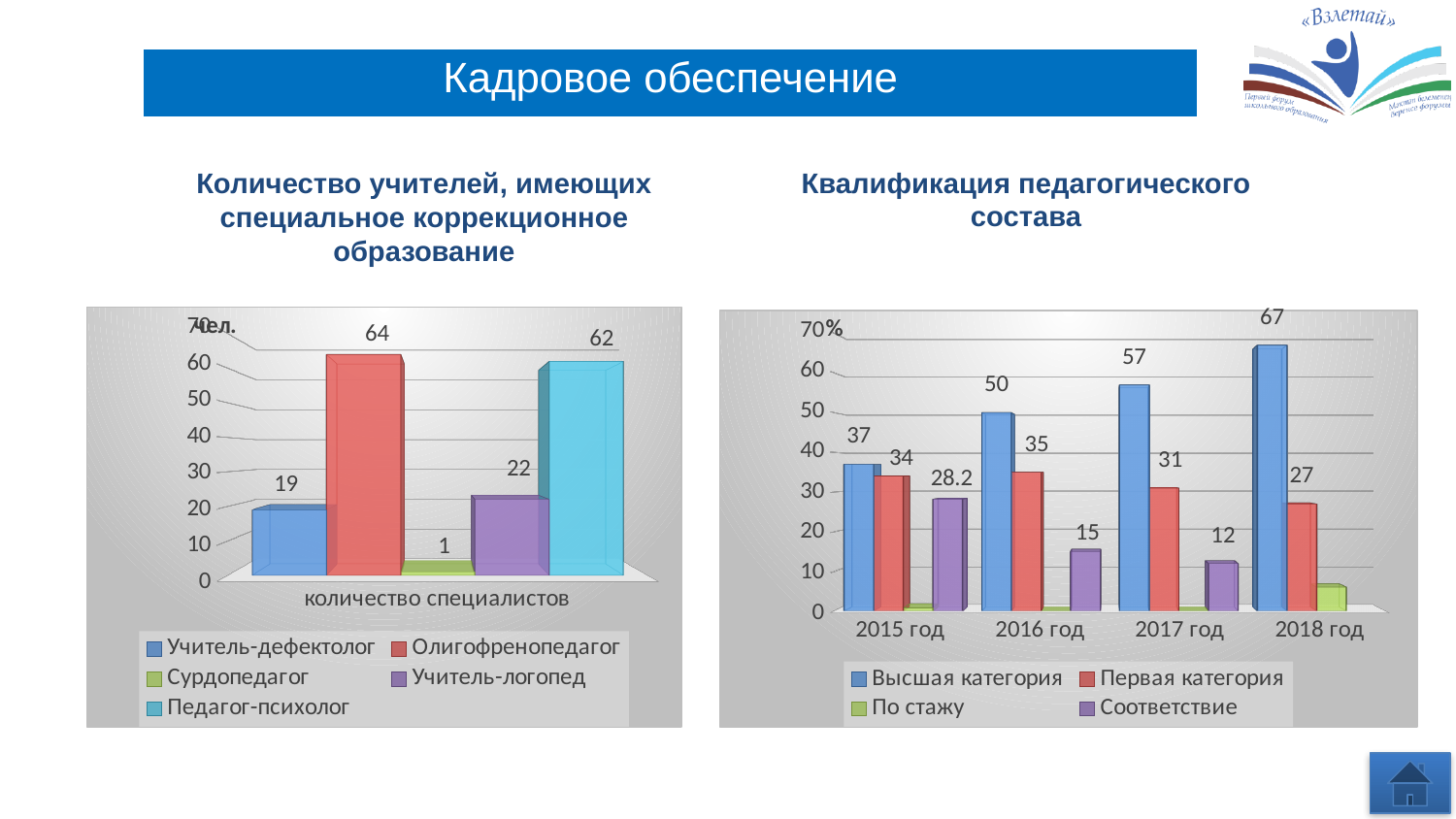
On the right chart, does the value for Высшая категория rise or fall from 2015 год to 2018 год? rise On the left chart, how many series does the legend list? 5 On the right chart, is the value for По стажу in 2018 год greater or less than 10? less On the right chart, which is larger in 2016 год: Высшая категория or Первая категория? Высшая категория On the right chart (Квалификация педагогического состава), what is the value for Высшая категория in 2017 год? 57 On the left chart, what is the value for Учитель-логопед? 22 On the left chart (Количество учителей, имеющих специальное коррекционное образование), what is the value for Олигофренопедагог? 64 On the right chart, what is the value for Соответствие in 2015 год? 28.2 On the left chart, which series has the lowest value? Сурдопедагог What kind of chart is the right chart? bar chart On the left chart, what is the difference between Олигофренопедагог and Педагог-психолог? 2 On the left chart, which series has the highest value? Олигофренопедагог